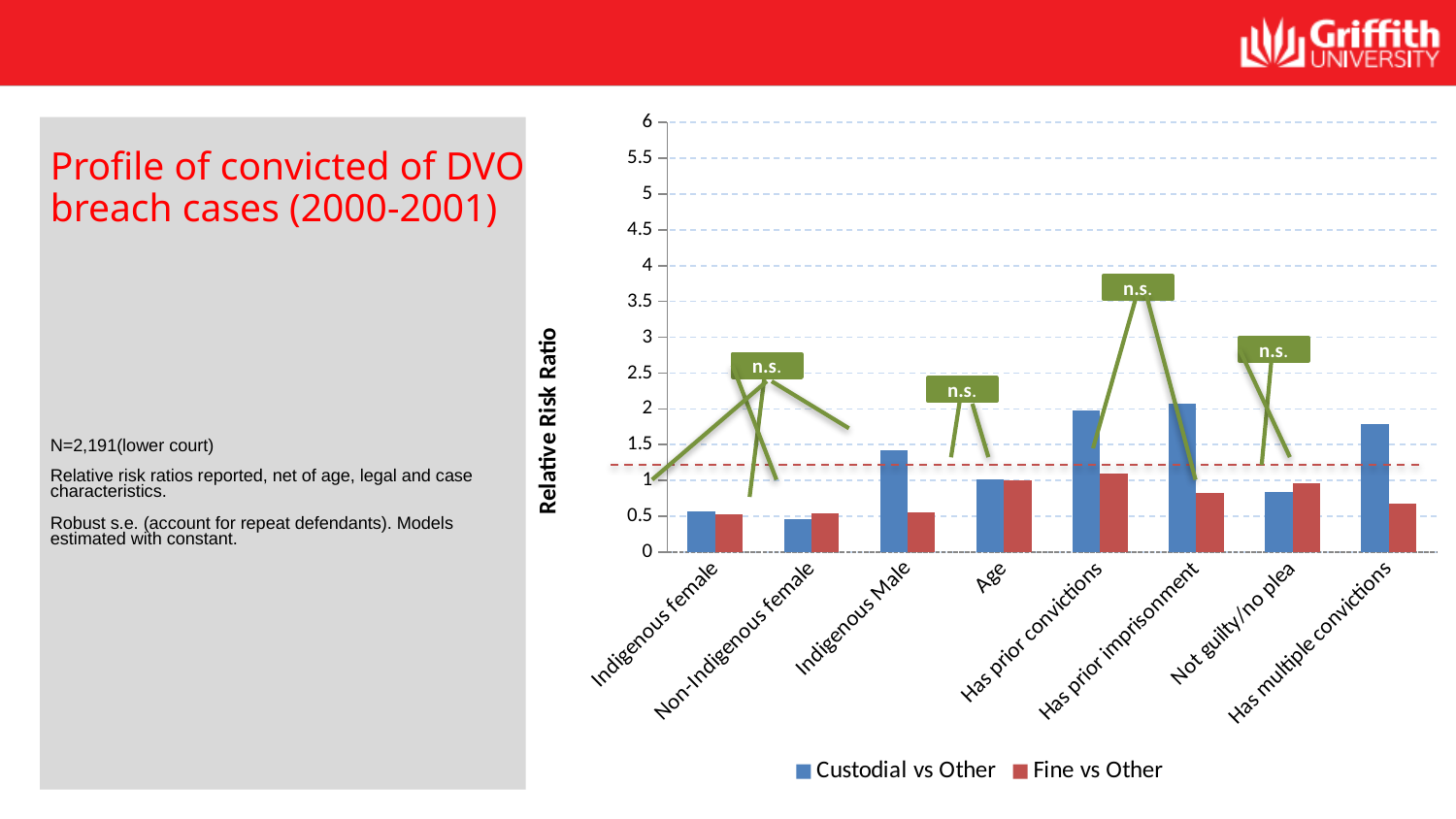
What are the two series named in the chart's legend? Custodial vs Other and Fine vs Other For Has prior imprisonment, which series has the larger value: Custodial vs Other or Fine vs Other? Custodial vs Other Is the Custodial vs Other value for Has multiple convictions greater or less than 1.5? greater How many series does the chart's legend list? 2 How many categories are shown along the x axis of the chart? 8 For Indigenous Male, which series has the larger value: Custodial vs Other or Fine vs Other? Custodial vs Other Is the Custodial vs Other value for Has prior convictions greater or less than 1.5? greater Is the Custodial vs Other value for Indigenous female greater or less than 1? less What is the title of the chart's vertical axis? Relative Risk Ratio What kind of chart is shown on the slide? Bar chart